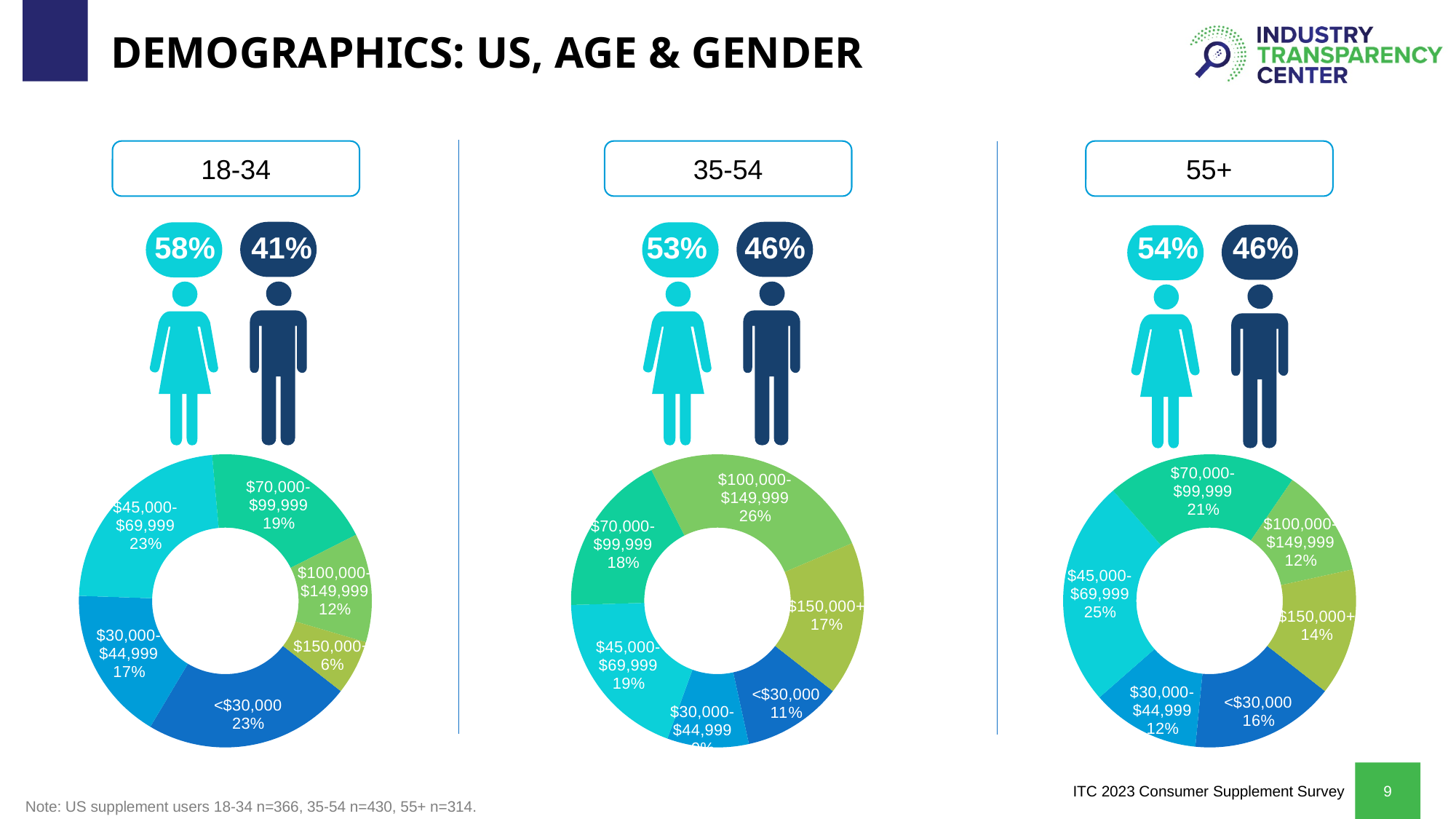
In the 18-34 donut chart, what is the difference in percentage points between the <$30,000 share and the $150,000+ share? 17 In the 55+ donut chart, which is larger: the share for $150,000+ or the share for $100,000-$149,999? $150,000+ In the 18-34 donut chart, which income bracket has the smallest share? $150,000+ How many income brackets are shown in the 18-34 donut chart? 6 In the 55+ donut chart, which income bracket has the largest share? $45,000-$69,999 In the 35-54 donut chart, which income bracket has the largest share? $100,000-$149,999 In the 35-54 donut chart, which is larger: the share for $70,000-$99,999 or the share for <$30,000? $70,000-$99,999 What percentage of the 18-34 age group is female according to the slide? 58% In the 55+ donut chart, what share of respondents have income of $45,000-$69,999? 25% What type of chart is used to show income distribution for each age group? Donut chart In the 18-34 donut chart, what share of respondents have income of $150,000+? 6% In the 35-54 donut chart, what share of respondents have income of $100,000-$149,999? 26%